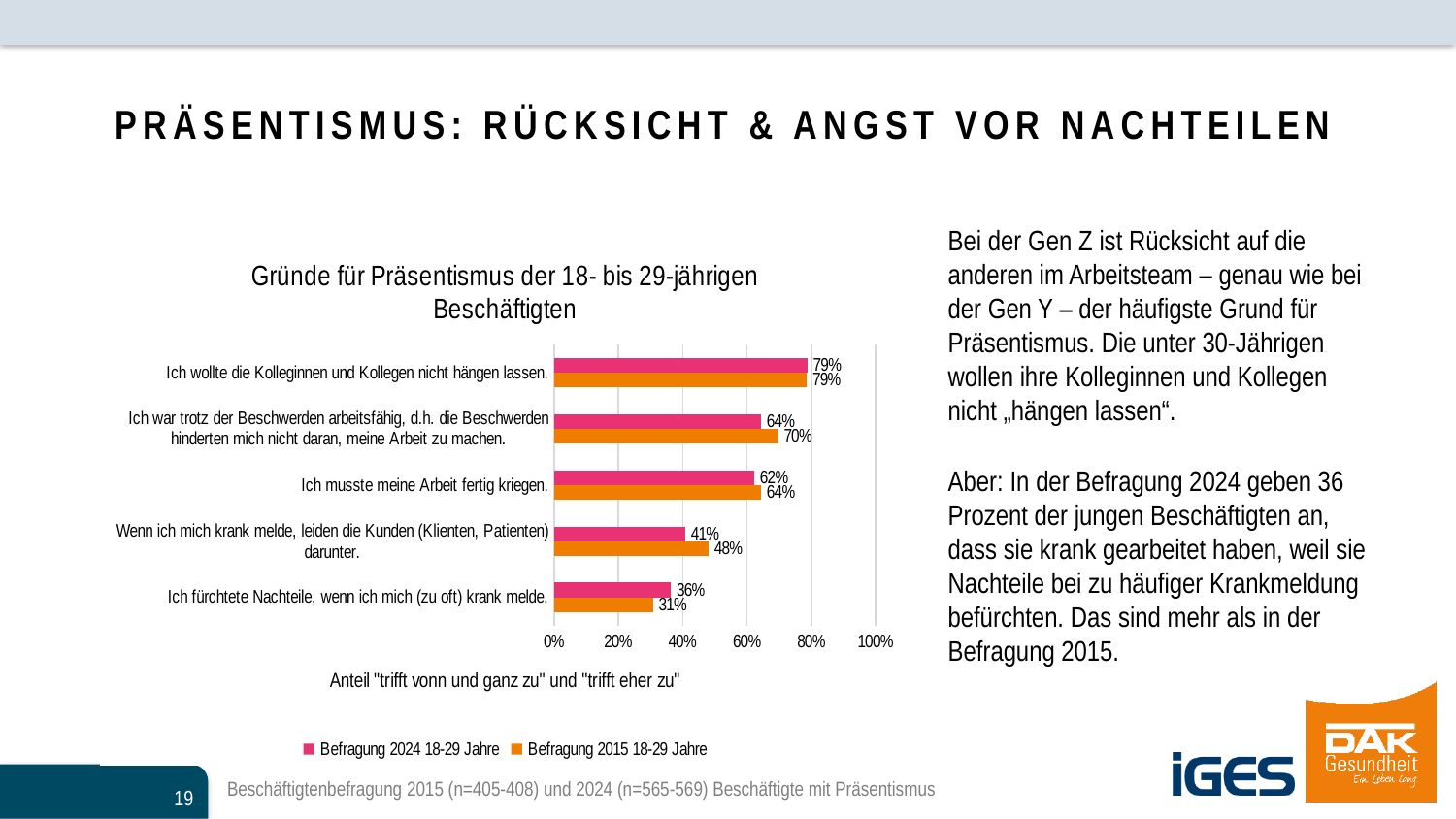
What type of chart is shown on the slide? bar chart Which colour represents the Befragung 2015 18-29 Jahre series? orange What is the value for "Ich war trotz der Beschwerden arbeitsfähig, d.h. die Beschwerden hinderten mich nicht daran, meine Arbeit zu machen." in the Befragung 2015 18-29 Jahre series? 70% What is the difference between the 2015 and 2024 values for "Wenn ich mich krank melde, leiden die Kunden (Klienten, Patienten) darunter."? 7% How many categories (reasons) are shown in the chart? 5 What is the value for "Ich fürchtete Nachteile, wenn ich mich (zu oft) krank melde." in the Befragung 2024 18-29 Jahre series? 36% What is the value for "Wenn ich mich krank melde, leiden die Kunden (Klienten, Patienten) darunter." in the Befragung 2024 18-29 Jahre series? 41% Which category has the lowest value in the Befragung 2015 18-29 Jahre series? Ich fürchtete Nachteile, wenn ich mich (zu oft) krank melde. Which category has the highest value in the Befragung 2024 18-29 Jahre series? Ich wollte die Kolleginnen und Kollegen nicht hängen lassen. How many series does the legend list? 2 What is the title of the chart? Gründe für Präsentismus der 18- bis 29-jährigen Beschäftigten For "Ich fürchtete Nachteile, wenn ich mich (zu oft) krank melde.", which survey has the larger value, Befragung 2024 or Befragung 2015? Befragung 2024 18-29 Jahre